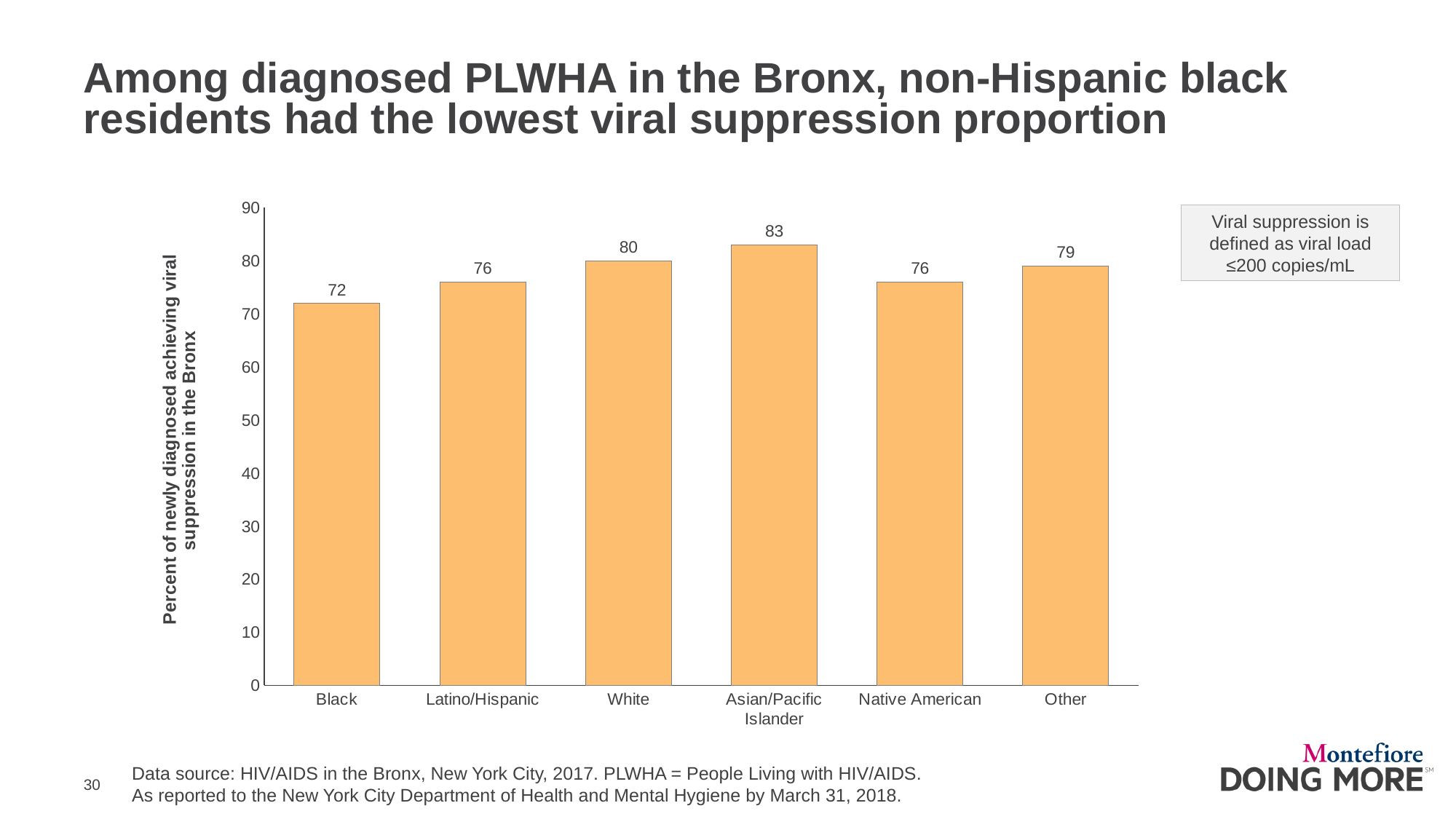
What is the label of the y axis? Percent of newly diagnosed achieving viral suppression in the Bronx Which is larger, the value for White or the value for Latino/Hispanic? White How many categories are shown on the x axis? 6 What kind of chart is shown on the slide? bar chart What is the value for White? 80 What is the value for Other? 79 Is the value for Native American greater or less than 70? greater What is the value for Asian/Pacific Islander? 83 What is the value for Black? 72 Which category has the highest value? Asian/Pacific Islander Which category has the lowest value? Black What is the difference between the values for Asian/Pacific Islander and Black? 11